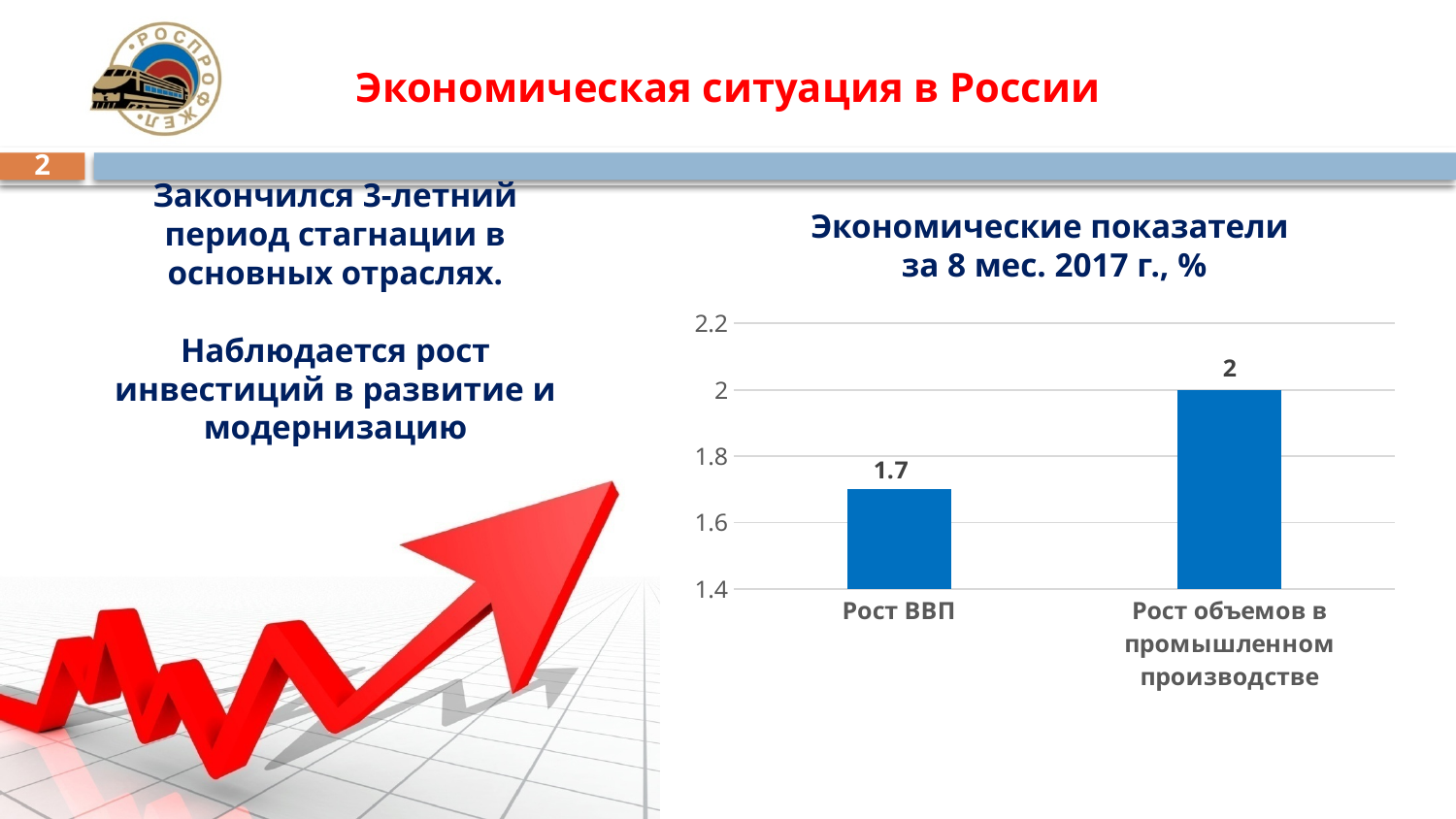
What is the lowest value shown on the vertical axis? 1.4 What is the difference between the value for Рост объемов в промышленном производстве and the value for Рост ВВП? 0.3 Is the value for Рост ВВП greater or less than 1.8? less What is the value for Рост объемов в промышленном производстве? 2 How many categories are shown in the chart? 2 Which is larger, the value for Рост ВВП or the value for Рост объемов в промышленном производстве? Рост объемов в промышленном производстве What kind of chart is shown on the slide? bar chart Which category has the highest value? Рост объемов в промышленном производстве Which category has the lowest value? Рост ВВП What is the value for Рост ВВП? 1.7 Do the values rise or fall from left to right across the categories? rise What is the title of the chart? Экономические показатели за 8 мес. 2017 г., %